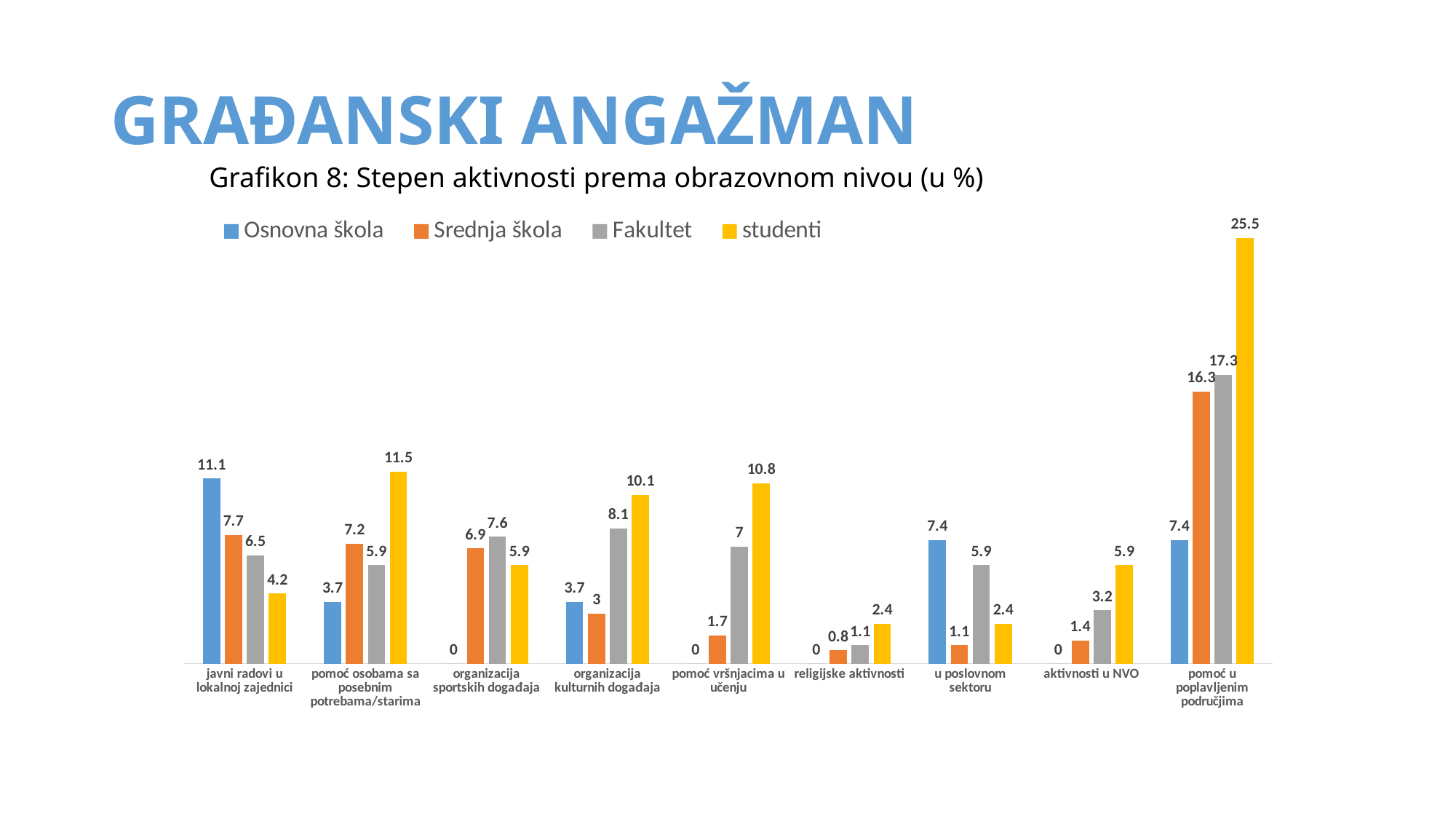
What is the difference between the studenti and Fakultet values in the category 'pomoć u poplavljenim područjima'? 8.2 What is the title of the chart? Grafikon 8: Stepen aktivnosti prema obrazovnom nivou (u %) How many series does the legend list? 4 What is the value for Fakultet in the category 'organizacija kulturnih događaja'? 8.1 What is the value for Osnovna škola in the category 'javni radovi u lokalnoj zajednici'? 11.1 How many categories are shown on the x axis? 9 What type of chart is shown on the slide? bar chart Which is larger in the category 'u poslovnom sektoru': the value for Osnovna škola or the value for Fakultet? Osnovna škola Which category has the lowest value for studenti? religijske aktivnosti and u poslovnom sektoru (both 2.4) What is the value for studenti in the category 'pomoć u poplavljenim područjima'? 25.5 Which category has the highest value for Srednja škola? pomoć u poplavljenim područjima What is the value for Srednja škola in the category 'pomoć vršnjacima u učenju'? 1.7